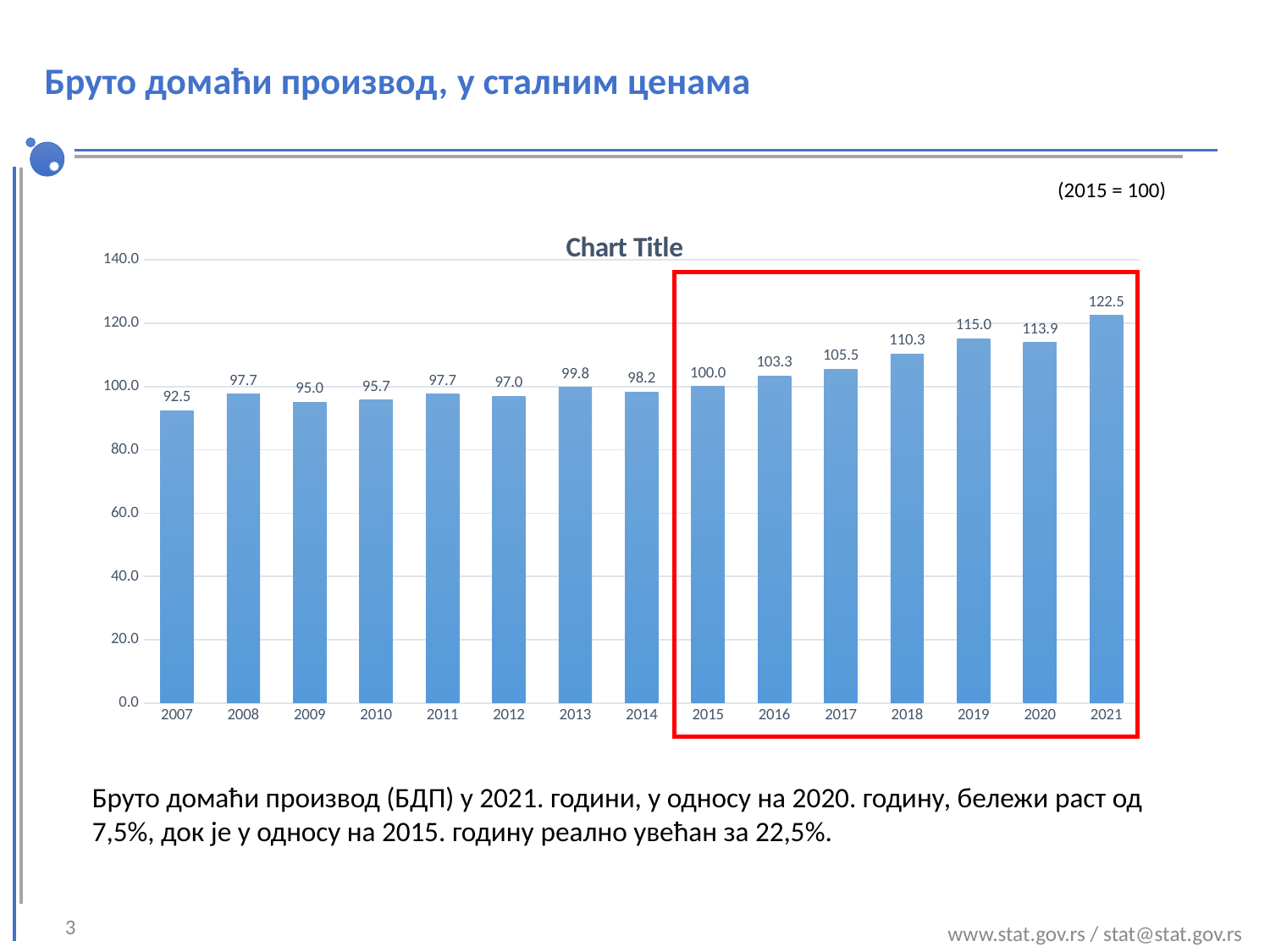
What is the difference between the values for 2021 and 2020? 8.6 Which is larger, the value for 2019 or the value for 2020? 2019 Which year has the lowest value? 2007 Do the values generally rise or fall from 2015 to 2021? rise What is the value for 2007? 92.5 How many years are shown on the x axis? 15 What is the value for 2021? 122.5 What is the title shown above the chart? Chart Title Which year has the highest value? 2021 What is the value for 2015? 100.0 What kind of chart is shown? bar chart Is the value for 2018 greater or less than 100.0? greater